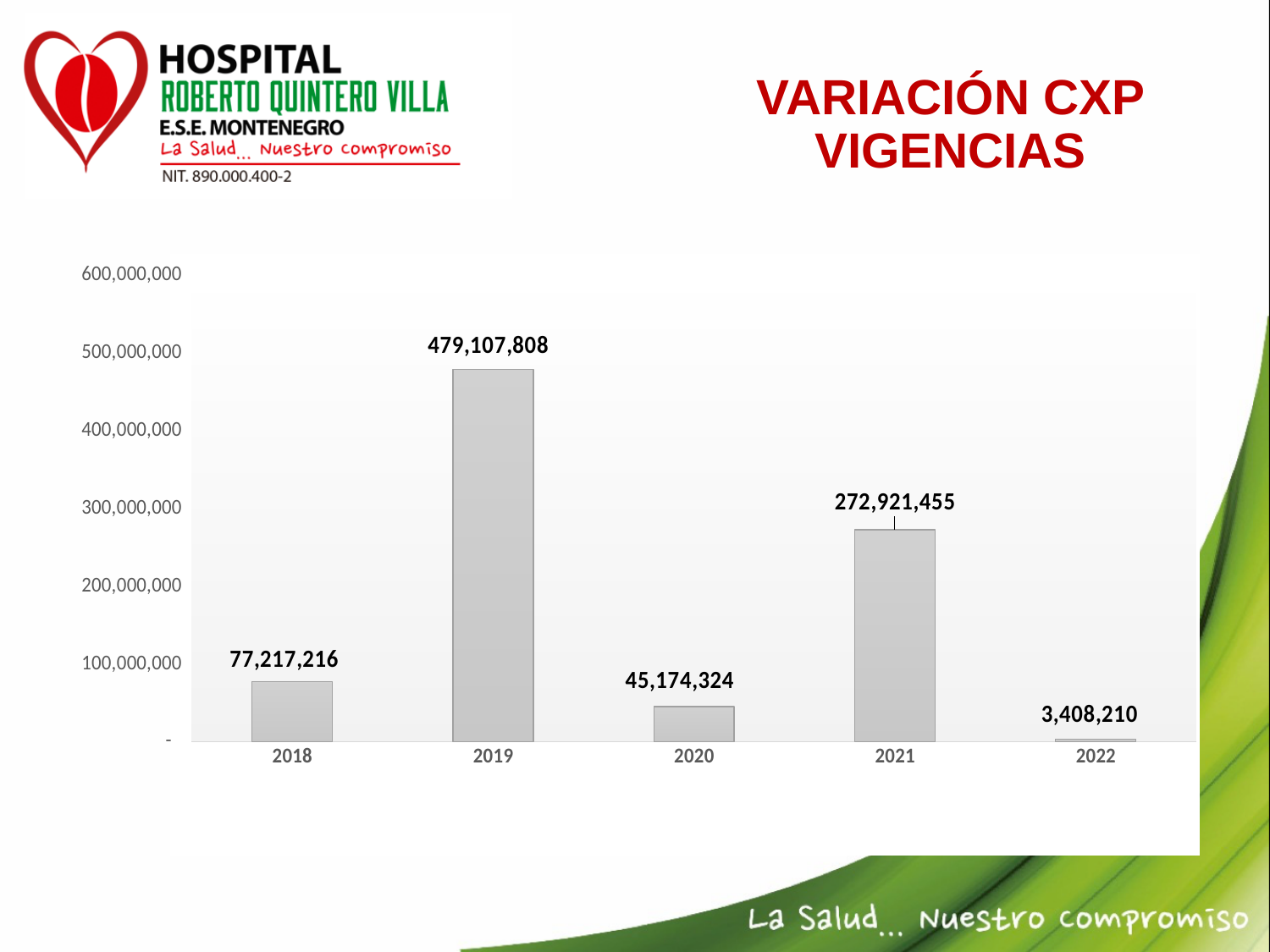
What is the value for 2021? 272,921,455 Which year has the highest value? 2019 What kind of chart is shown on the slide? Bar chart What is the value for 2019? 479,107,808 Is the value for 2021 greater or less than 300,000,000? less What is the difference between the values for 2018 and 2020? 32,042,892 What is the value for 2022? 3,408,210 How many years are shown on the x axis? 5 Which is larger, the value for 2018 or the value for 2020? 2018 Which year has the lowest value? 2022 What is the value for 2018? 77,217,216 What is the difference between the values for 2019 and 2021? 206,186,353